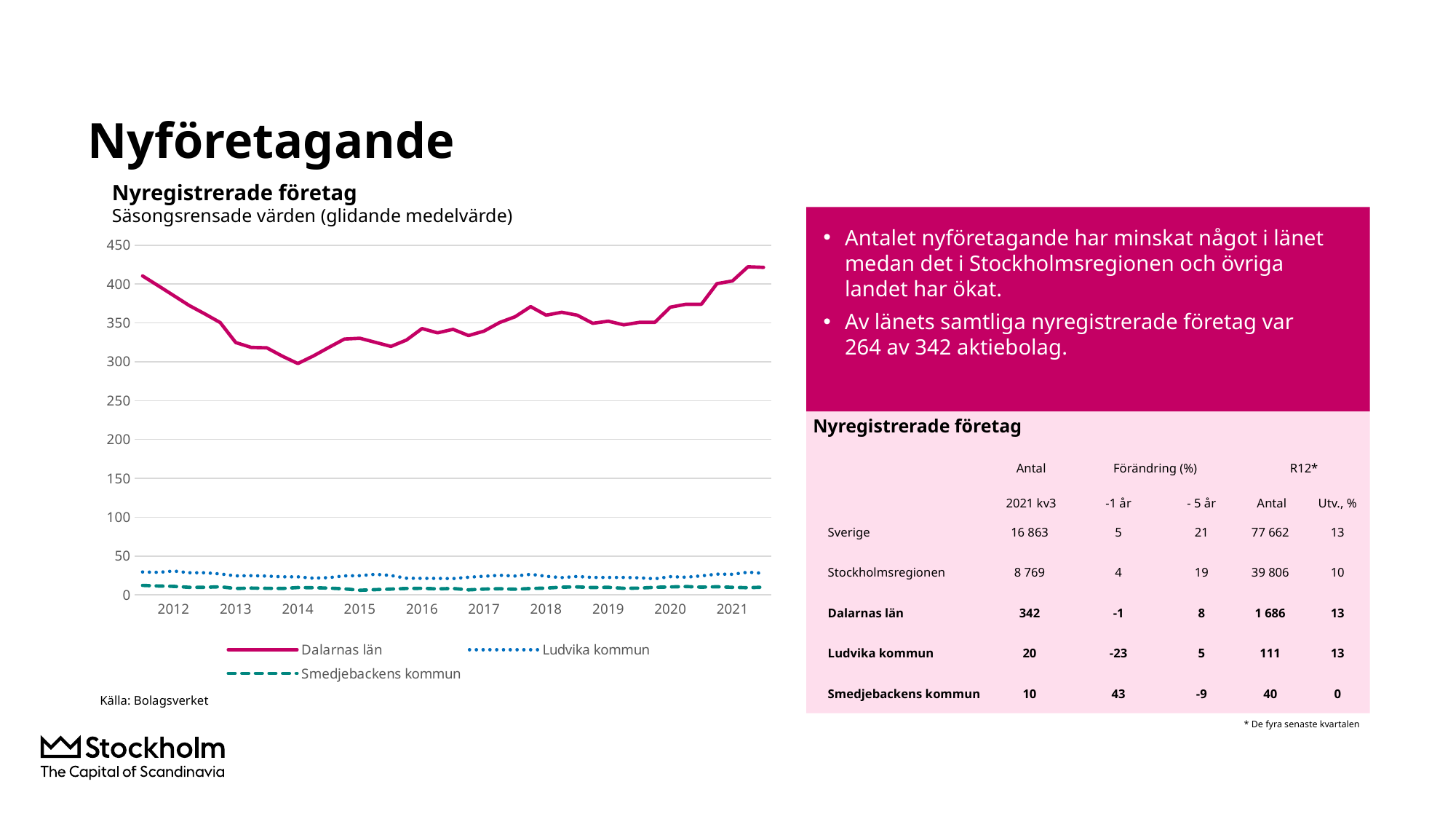
What is the title of the chart? Nyregistrerade företag How many year labels are shown on the x axis of the chart? 10 Does the Dalarnas län line rise or fall between 2012 and 2014? Fall Which series has the lowest values throughout the chart? Smedjebackens kommun Which series are listed in the chart legend? Dalarnas län, Ludvika kommun, Smedjebackens kommun Which series has the highest values throughout the chart? Dalarnas län What kind of chart is shown on the slide? Line chart Is the value for Ludvika kommun in 2018 greater or less than 50? less Is the value for Dalarnas län in 2016 greater or less than 400? less Is the value for Dalarnas län at the end of 2021 greater or less than 400? greater How many series does the chart legend list? 3 Which series is higher in the chart, Ludvika kommun or Smedjebackens kommun? Ludvika kommun